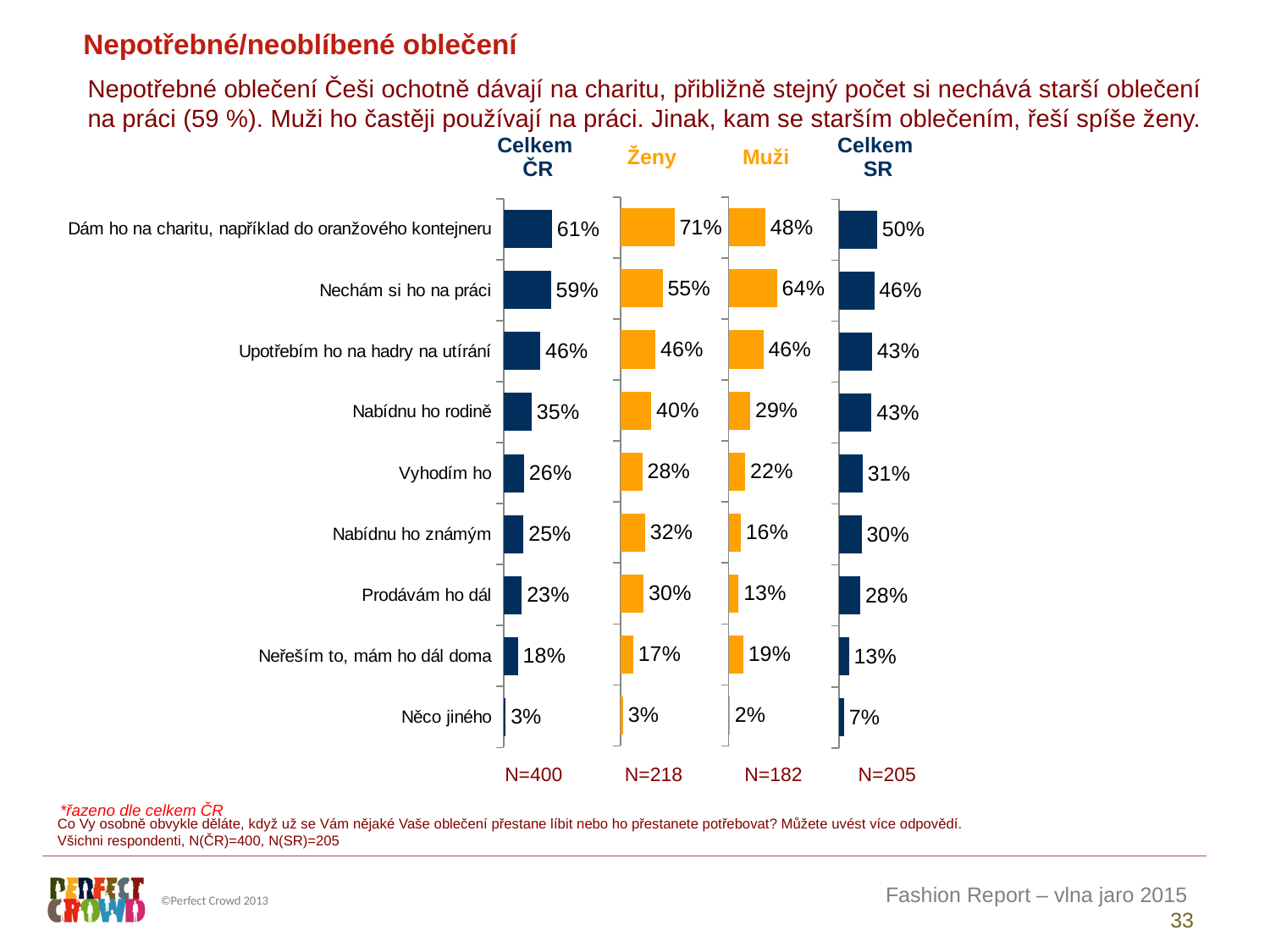
How many categories are shown in the Celkem ČR chart? 9 What is the difference between the Ženy and Muži values for "Nabídnu ho známým"? 16% In the Celkem ČR chart, what is the value for "Nechám si ho na práci"? 59% In the Celkem ČR chart, what is the difference between "Dám ho na charitu, například do oranžového kontejneru" and "Vyhodím ho"? 35% In the Ženy chart, what is the value for "Dám ho na charitu, například do oranžového kontejneru"? 71% For "Nabídnu ho rodině", which is larger: the Ženy value or the Muži value? Ženy In the Celkem SR chart, what is the value for "Něco jiného"? 7% In the Celkem SR chart, which category has the lowest value? Něco jiného What type of chart is used on this slide? Bar chart In the Muži chart, what is the value for "Prodávám ho dál"? 13% What is the sample size (N) shown under the Muži chart? N=182 In the Muži chart, which category has the highest value? Nechám si ho na práci